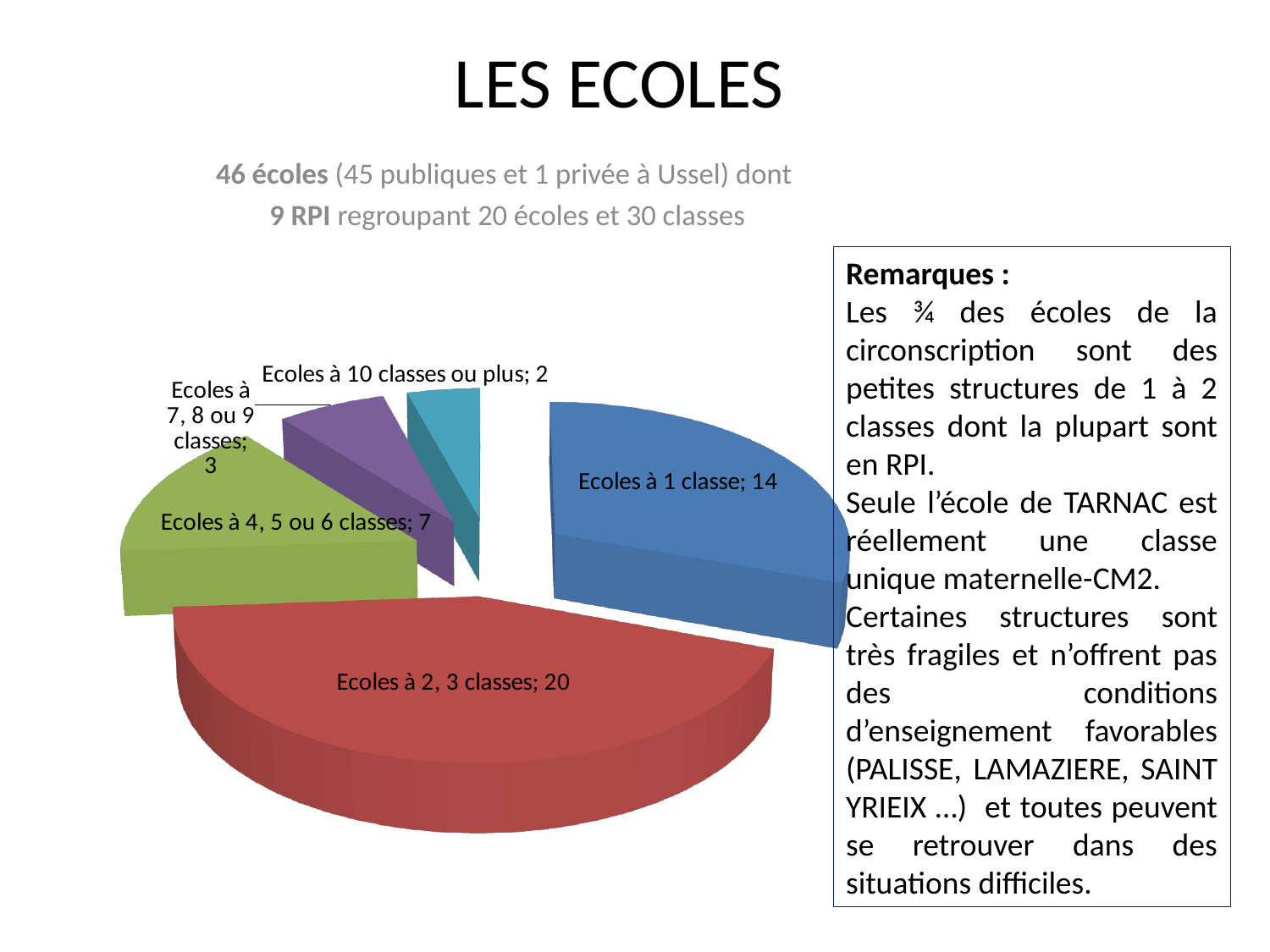
What is the value for "Ecoles à 7, 8 ou 9 classes"? 3 Which category has the largest slice of the pie? Ecoles à 2, 3 classes What kind of chart is shown on the slide? pie chart What is the value for "Ecoles à 2, 3 classes"? 20 Which category has the smallest slice of the pie? Ecoles à 10 classes ou plus What is the difference between the values for "Ecoles à 2, 3 classes" and "Ecoles à 1 classe"? 6 What is the value for "Ecoles à 1 classe"? 14 What is the value for "Ecoles à 4, 5 ou 6 classes"? 7 How many slices does the pie chart have? 5 Which is larger, the value for "Ecoles à 4, 5 ou 6 classes" or the value for "Ecoles à 7, 8 ou 9 classes"? Ecoles à 4, 5 ou 6 classes What is the value for "Ecoles à 10 classes ou plus"? 2 What is the total of all the slice values in the pie chart? 46